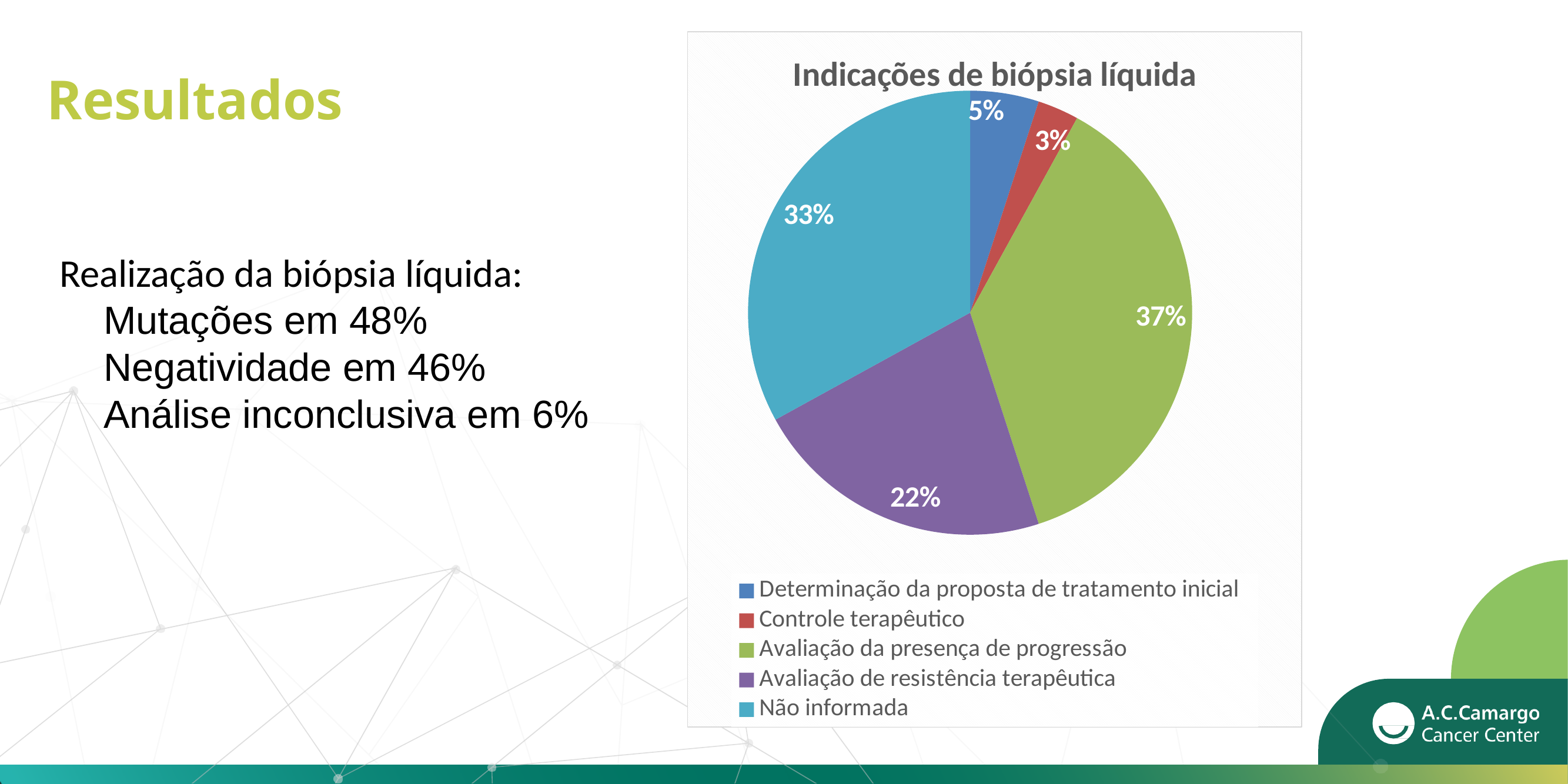
Which category has the smallest slice of the pie? Controle terapêutico Which category has the largest slice of the pie? Avaliação da presença de progressão What share of the pie does 'Não informada' represent? 33% How many categories does the pie chart have? 5 What is the difference between the shares of 'Não informada' and 'Avaliação de resistência terapêutica'? 11% What is the title of the chart? Indicações de biópsia líquida What kind of chart is shown on the slide? Pie chart What is the value for 'Controle terapêutico'? 3% Which is larger, the share for 'Não informada' or the share for 'Avaliação da presença de progressão'? Avaliação da presença de progressão What share of the pie does 'Avaliação da presença de progressão' represent? 37% What is the value for 'Avaliação de resistência terapêutica'? 22% What is the value for 'Determinação da proposta de tratamento inicial'? 5%